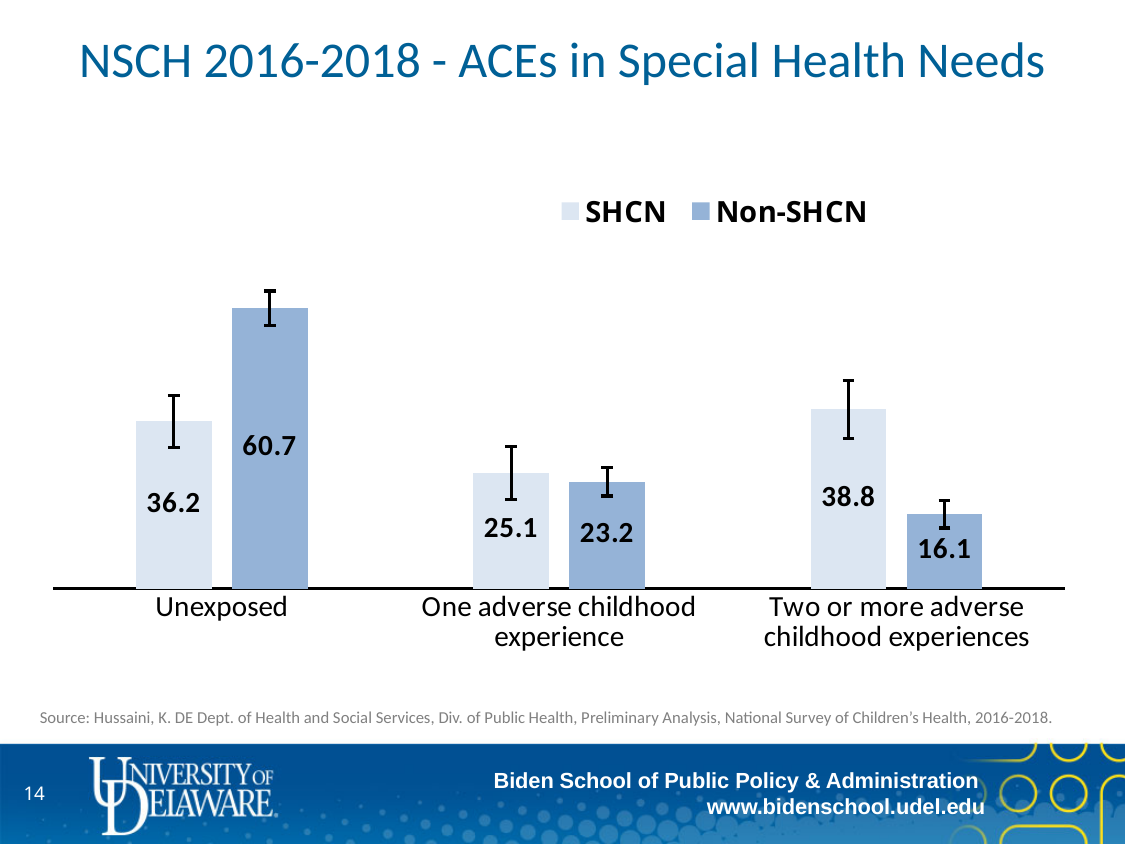
What is the SHCN value for Unexposed? 36.2 What is the SHCN value for One adverse childhood experience? 25.1 What is the difference between the SHCN and Non-SHCN values for Two or more adverse childhood experiences? 22.7 What is the Non-SHCN value for Unexposed? 60.7 What kind of chart is shown on the slide? Bar chart Which category has the lowest SHCN value? One adverse childhood experience Which category has the highest Non-SHCN value? Unexposed How many categories are shown on the x axis? 3 For Two or more adverse childhood experiences, which series has the larger value, SHCN or Non-SHCN? SHCN What is the difference between the Non-SHCN and SHCN values for Unexposed? 24.5 How many series does the legend list? 2 What is the Non-SHCN value for Two or more adverse childhood experiences? 16.1